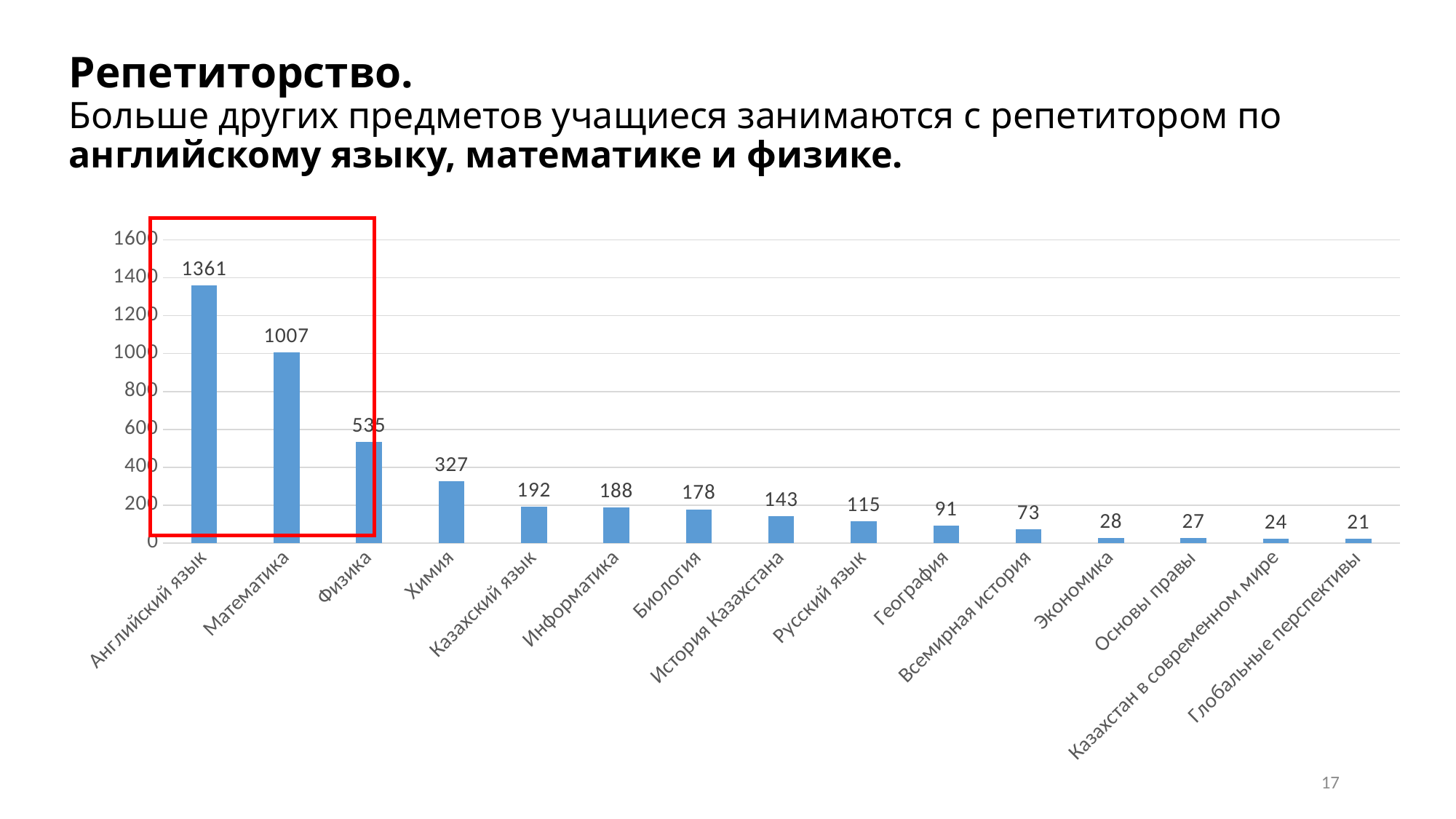
What is the difference between the values for Английский язык and Математика? 354 Which is larger, the value for Информатика or the value for Биология? Информатика Which category has the lowest value? Глобальные перспективы Is the value for Математика greater or less than 800? greater Do the values rise or fall from left to right along the x axis? fall Which category has the highest value? Английский язык What kind of chart is shown on the slide? bar chart What is the difference between the values for Химия and Казахский язык? 135 How many categories are shown on the x axis? 15 What is the value for История Казахстана? 143 What is the value for Физика? 535 What is the value for Английский язык? 1361